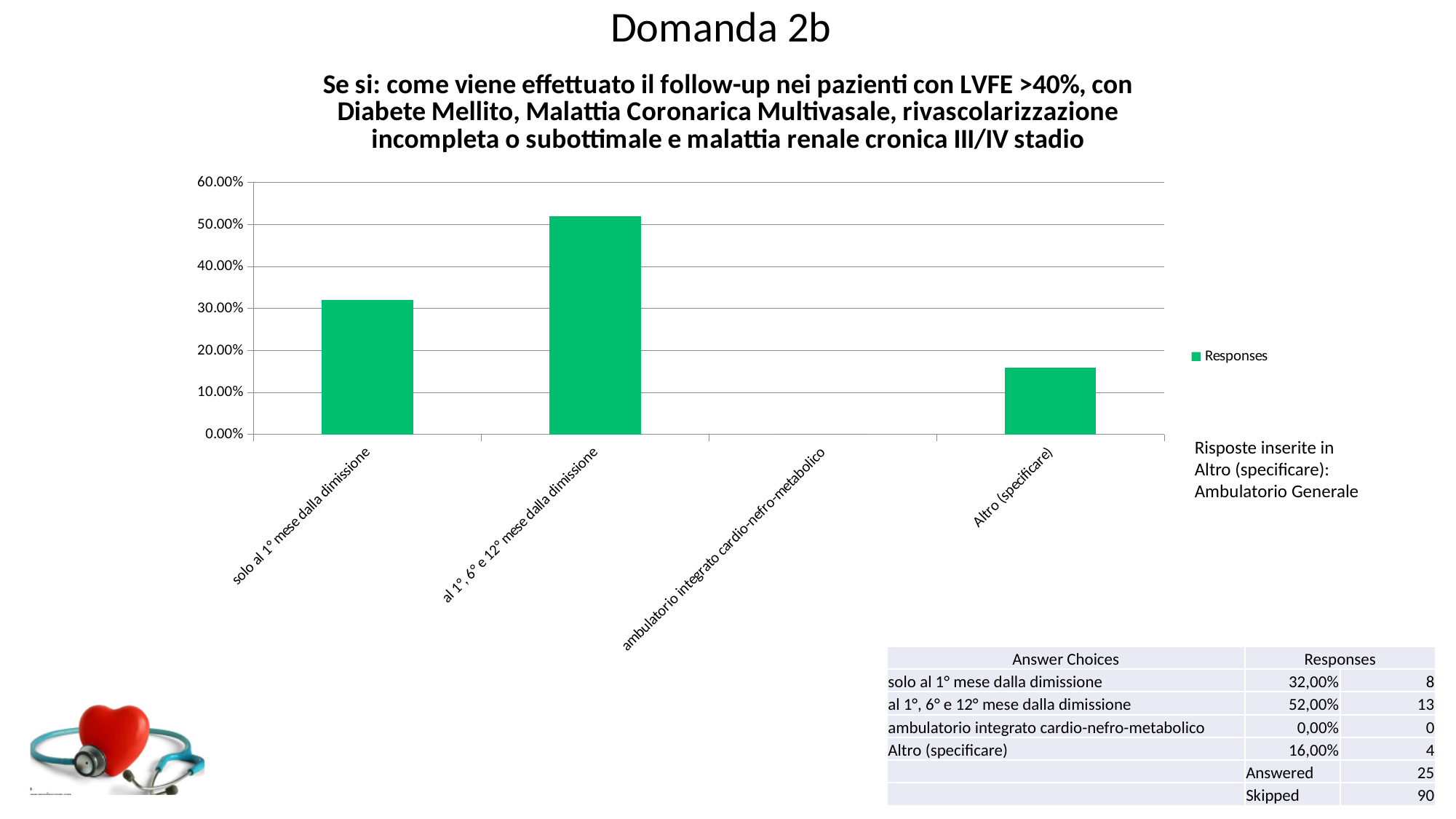
What is the response percentage for 'al 1°, 6° e 12° mese dalla dimissione'? 52,00% Which is larger: the value for 'solo al 1° mese dalla dimissione' or the value for 'Altro (specificare)'? solo al 1° mese dalla dimissione Which category has the lowest value in the chart? ambulatorio integrato cardio-nefro-metabolico What is the response percentage for 'Altro (specificare)'? 16,00% Which category has the highest value in the chart? al 1°, 6° e 12° mese dalla dimissione What is the name of the series shown in the chart legend? Responses What type of chart is shown on the slide? bar chart What is the response percentage for 'solo al 1° mese dalla dimissione'? 32,00% How many series does the chart legend list? 1 What is the difference in percentage points between 'al 1°, 6° e 12° mese dalla dimissione' and 'solo al 1° mese dalla dimissione'? 20,00% How many categories are plotted on the x axis of the chart? 4 Is the value for 'al 1°, 6° e 12° mese dalla dimissione' greater or less than 50.00%? greater